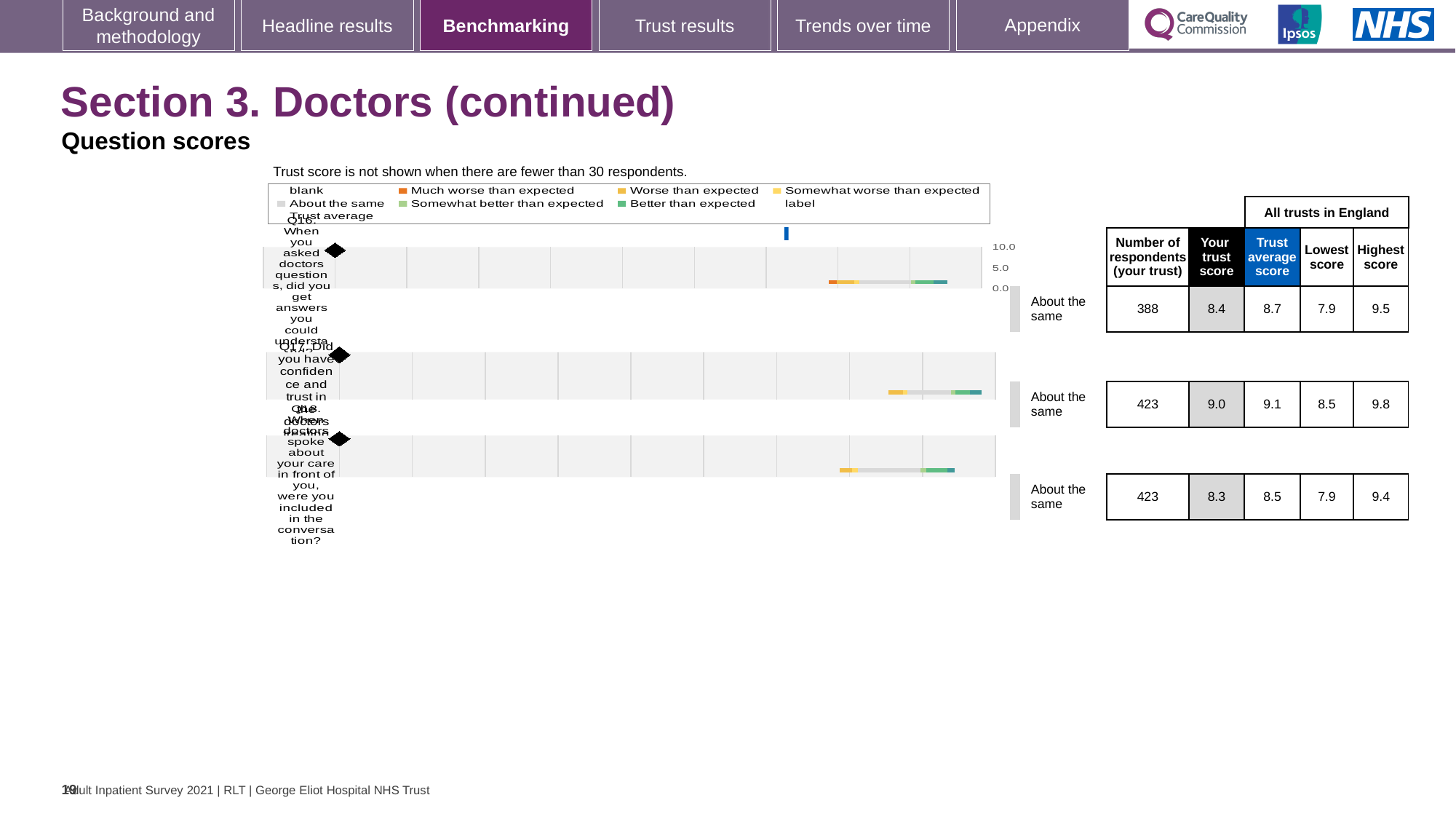
What is the 'Your trust score' for Q17 (Did you have confidence and trust in the doctors treating you)? 9.0 What is the difference between the highest score and the lowest score for Q16? 1.6 What kind of chart is used to show the question scores? bar chart Which question has the highest 'Your trust score'? Q17 What benchmark category is shown for all three questions? About the same Which is larger: your trust score for Q16 or your trust score for Q17? Q17 How many questions are plotted on the chart? 3 What is the trust average score across all trusts in England for Q18? 8.5 Which question has the lowest 'Your trust score'? Q18 What is the highest score among all trusts in England for Q16? 9.5 How many respondents from your trust answered Q16? 388